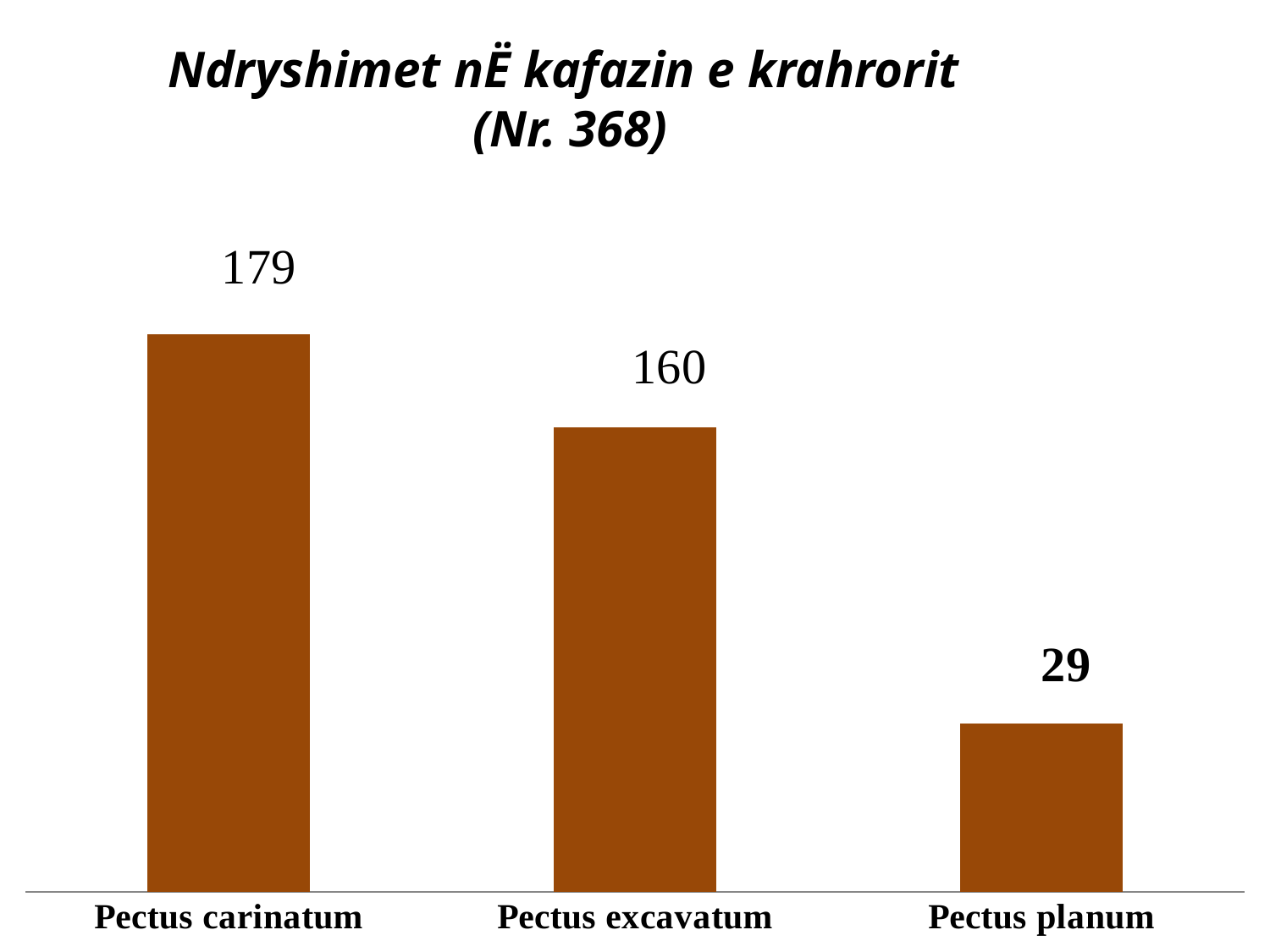
What is the difference between the values for Pectus carinatum and Pectus excavatum? 19 Which is larger, the value for Pectus excavatum or the value for Pectus planum? Pectus excavatum What is the value for Pectus planum? 29 What kind of chart is shown on the slide? Bar chart What is the value for Pectus excavatum? 160 What is the value for Pectus carinatum? 179 Which category has the highest value? Pectus carinatum Do the values rise or fall from left to right across the categories? Fall What is the difference between the values for Pectus excavatum and Pectus planum? 131 What is the title of the chart? Ndryshimet nË kafazin e krahrorit (Nr. 368) How many categories are shown in the chart? 3 Which category has the lowest value? Pectus planum